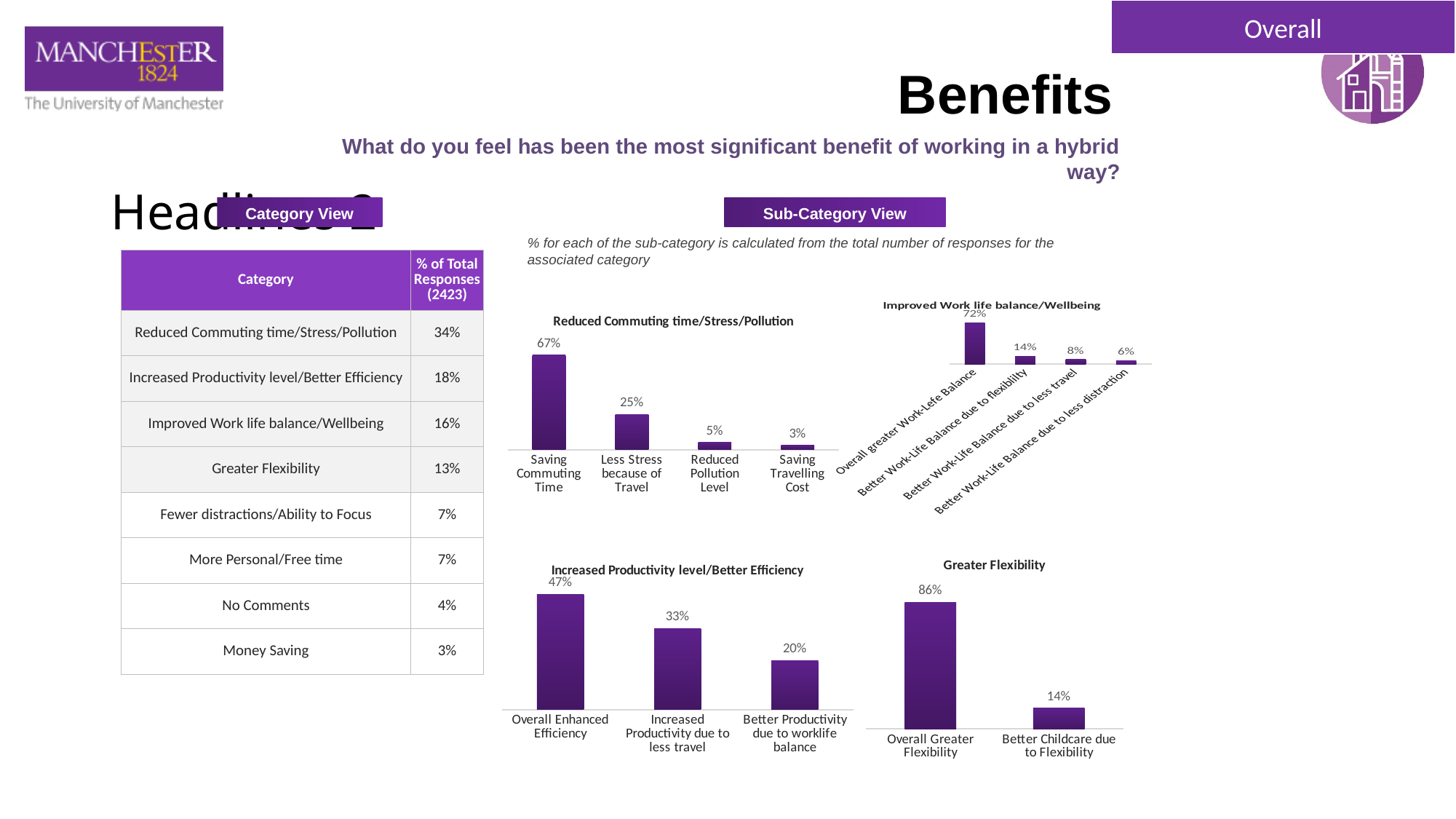
In the 'Reduced Commuting time/Stress/Pollution' chart, what is the difference between Saving Commuting Time and Less Stress because of Travel? 42% In the 'Reduced Commuting time/Stress/Pollution' chart, which category has the lowest value? Saving Travelling Cost In the 'Reduced Commuting time/Stress/Pollution' chart, what is the value for Saving Commuting Time? 67% In the 'Improved Work life balance/Wellbeing' chart, which is larger: Better Work-Life Balance due to less travel or Better Work-Life Balance due to less distraction? Better Work-Life Balance due to less travel In the 'Improved Work life balance/Wellbeing' chart, which category has the highest value? Overall greater Work-Life Balance How many categories are shown in the 'Reduced Commuting time/Stress/Pollution' chart? 4 In the 'Greater Flexibility' chart, what is the value for Better Childcare due to Flexibility? 14% What kind of chart is the 'Greater Flexibility' chart? bar chart In the 'Improved Work life balance/Wellbeing' chart, what is the value for Better Work-Life Balance due to flexibility? 14% In the 'Increased Productivity level/Better Efficiency' chart, what is the value for Increased Productivity due to less travel? 33% In the 'Greater Flexibility' chart, what is the difference between Overall Greater Flexibility and Better Childcare due to Flexibility? 72% In the 'Increased Productivity level/Better Efficiency' chart, do the values rise or fall from left to right? fall